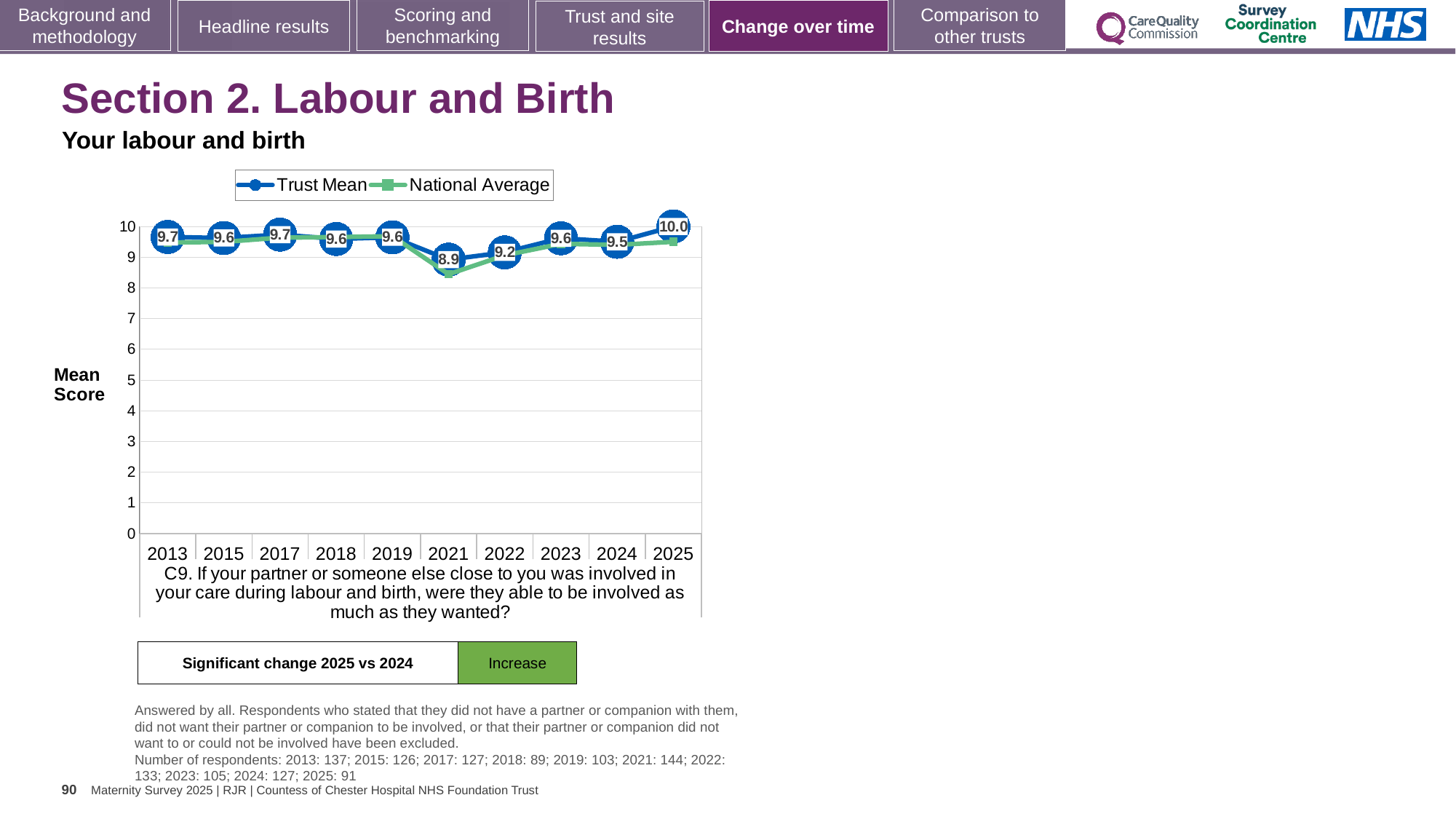
In which year is the Trust Mean lowest? 2021 Is the National Average for 2021 greater or less than 9? less What is the difference between the Trust Mean in 2025 and in 2024? 0.5 What is the Trust Mean for 2021? 8.9 Which is larger, the Trust Mean in 2022 or in 2023? 2023 In which year is the Trust Mean highest? 2025 What kind of chart is shown? line chart What is the Trust Mean for 2025? 10.0 What is the Trust Mean for 2022? 9.2 How many series does the legend list? 2 How many years are shown on the x axis? 10 What is the Trust Mean for 2024? 9.5